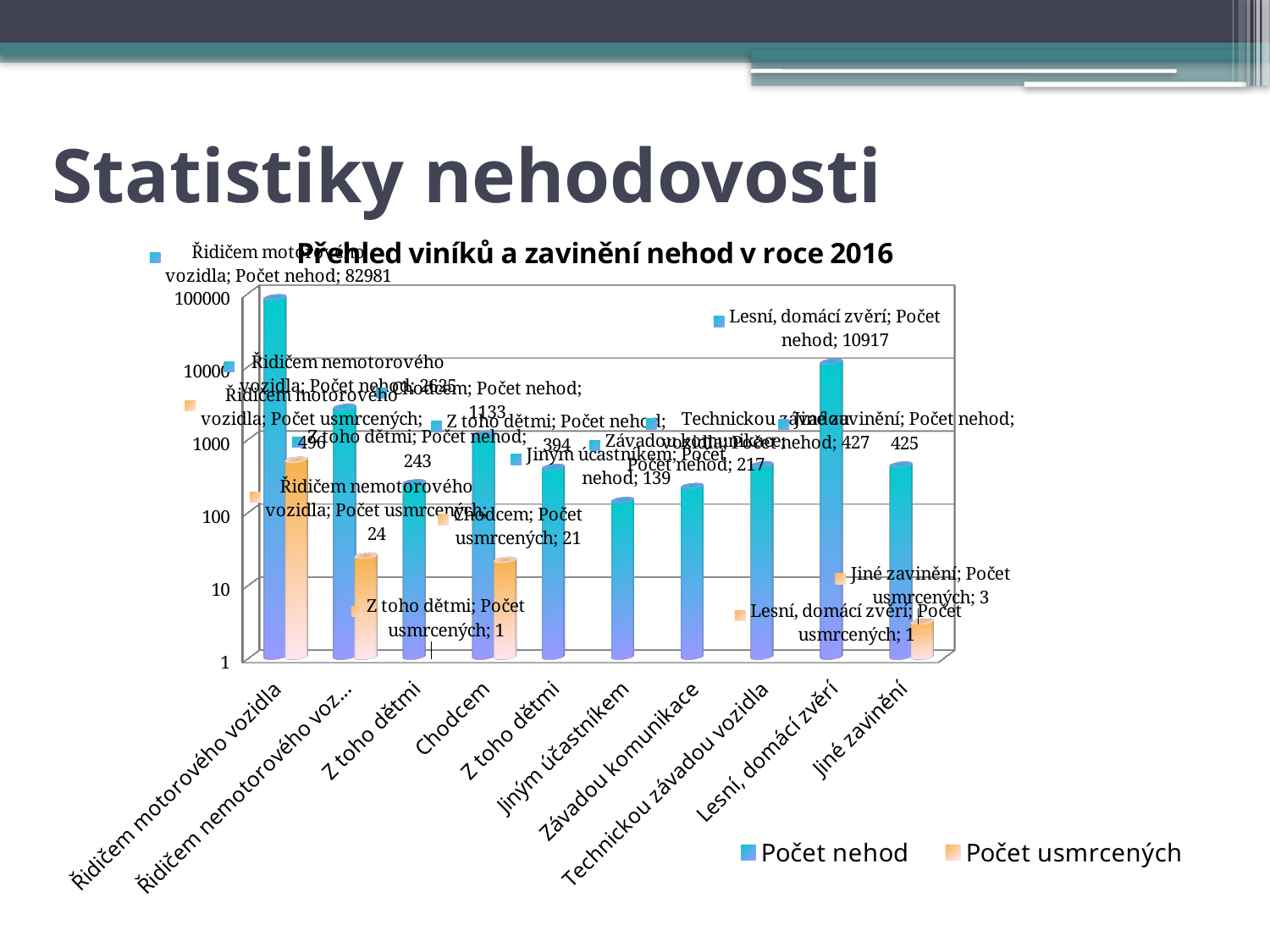
How many categories are shown on the x axis? 10 Is the Počet nehod value for Závadou komunikace greater or less than 1000? less What is the value of Počet nehod for Lesní, domácí zvěří? 10917 Which has a larger Počet nehod: Lesní, domácí zvěří or Chodcem? Lesní, domácí zvěří What type of chart is shown on the slide? bar chart What is the value of Počet usmrcených for Chodcem? 21 What is the difference in Počet nehod between Lesní, domácí zvěří and Řidičem nemotorového vozidla? 8292 How many series does the legend list? 2 Which category has the highest Počet nehod? Řidičem motorového vozidla What is the value of Počet nehod for Jiným účastníkem? 139 What is the value of Počet nehod for Řidičem motorového vozidla? 82981 Which category has the lowest Počet nehod? Jiným účastníkem